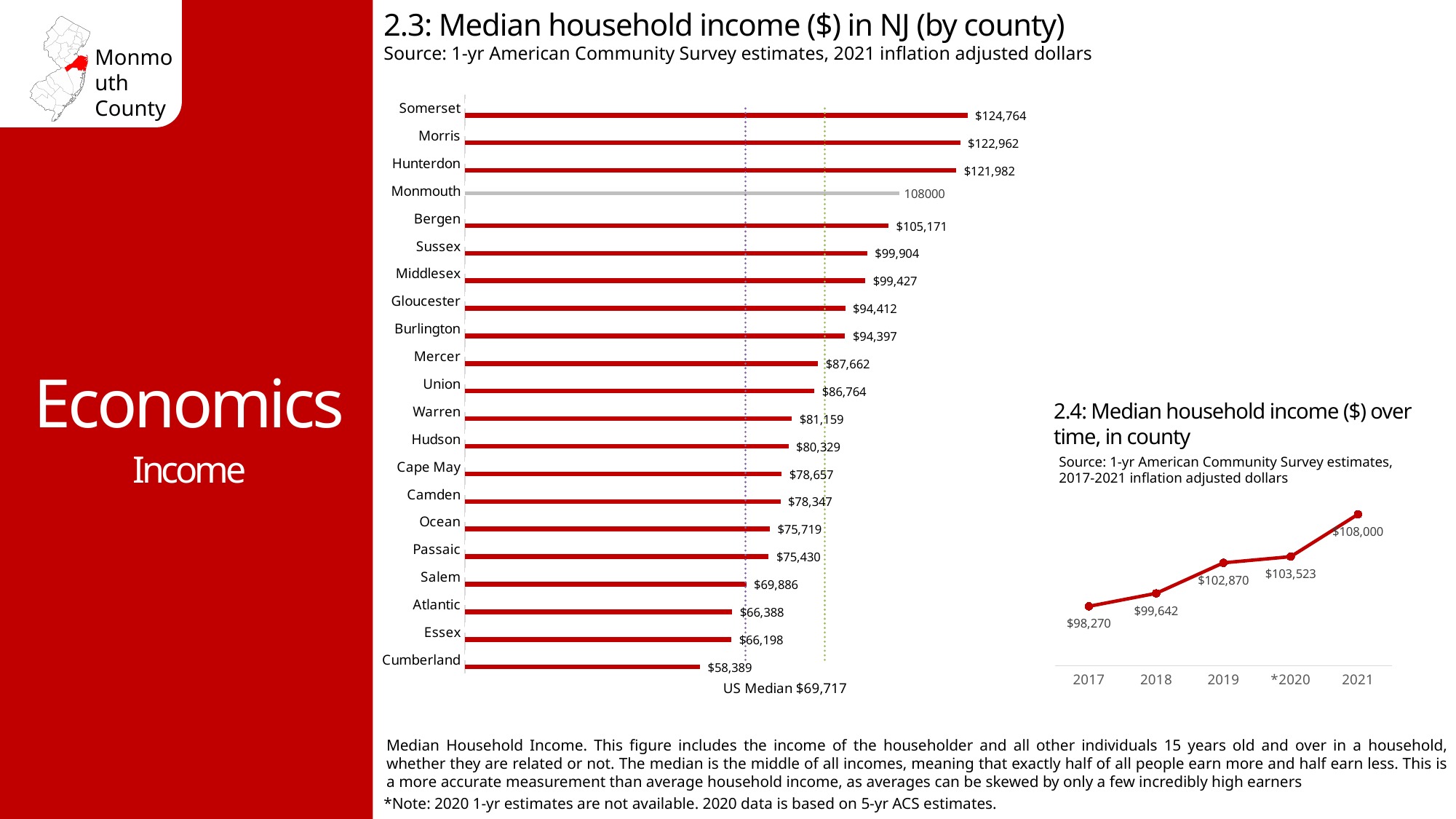
In chart 2.3 (Median household income in NJ by county), what is the difference between Somerset's and Cumberland's median household income? $66,375 What type of chart is chart 2.3 (Median household income in NJ by county)? Bar chart In chart 2.3 (Median household income in NJ by county), which has a higher median household income, Bergen or Hudson? Bergen In chart 2.3 (Median household income in NJ by county), how many counties are shown? 21 In chart 2.4 (Median household income over time, in county), what is the difference between the 2021 and 2017 values? $9,730 In chart 2.3 (Median household income in NJ by county), what is the median household income for Somerset? $124,764 In chart 2.3 (Median household income in NJ by county), what US Median value is noted below the chart? $69,717 In chart 2.3 (Median household income in NJ by county), which county has the highest median household income? Somerset In chart 2.4 (Median household income over time, in county), do values rise or fall from 2017 to 2021? Rise In chart 2.4 (Median household income over time, in county), what is the median household income for 2019? $102,870 In chart 2.3 (Median household income in NJ by county), which county has the lowest median household income? Cumberland In chart 2.3 (Median household income in NJ by county), what value is labeled for Monmouth? 108000